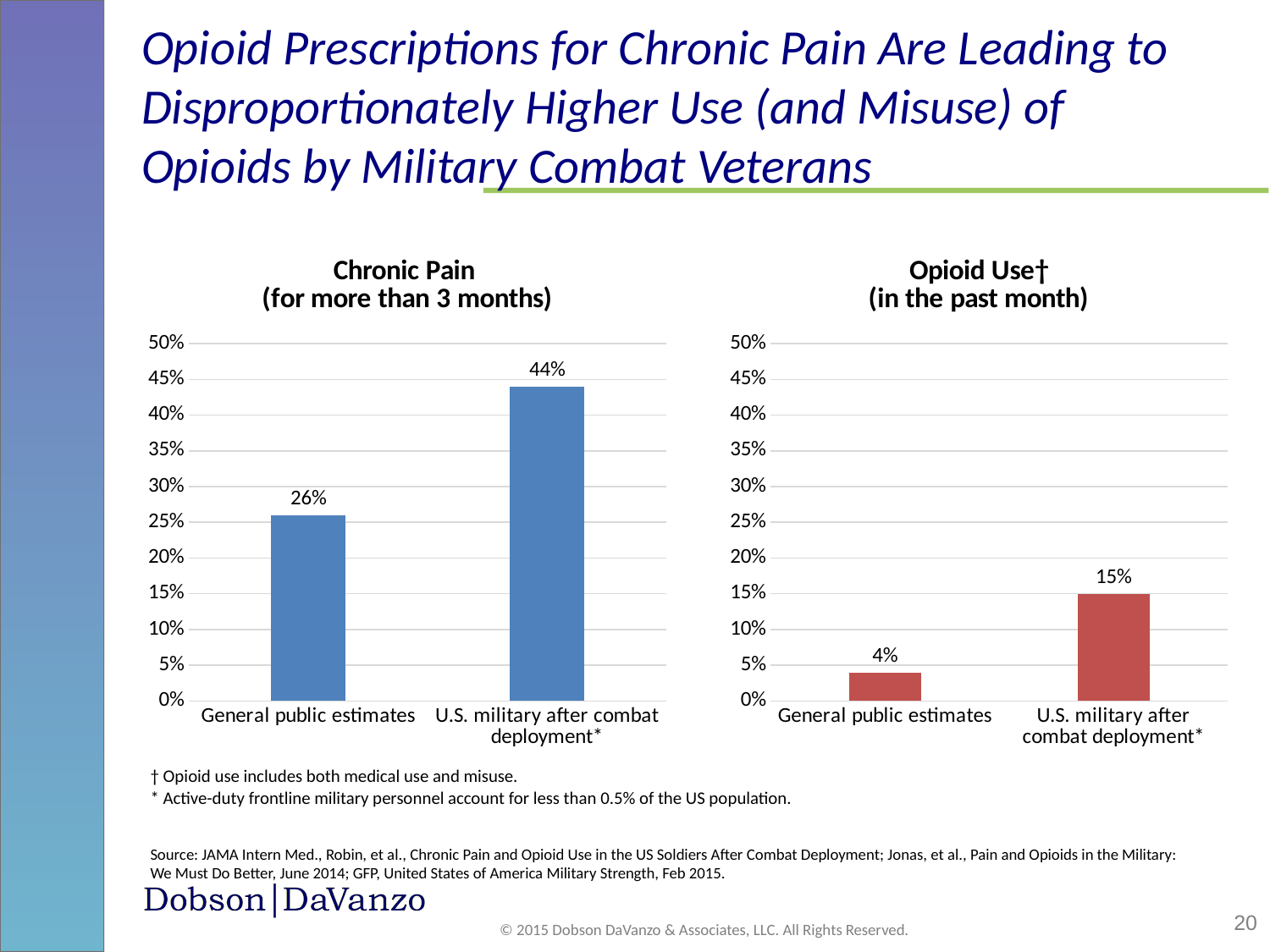
In the Chronic Pain (for more than 3 months) chart, what is the value for U.S. military after combat deployment*? 44% In the Opioid Use† (in the past month) chart, which category has the lowest value? General public estimates In the Opioid Use† (in the past month) chart, what is the value for General public estimates? 4% In the Chronic Pain (for more than 3 months) chart, what is the difference between the U.S. military after combat deployment* value and the General public estimates value? 18% In the Opioid Use† (in the past month) chart, which is larger: General public estimates or U.S. military after combat deployment*? U.S. military after combat deployment* In the Chronic Pain (for more than 3 months) chart, which category has the highest value? U.S. military after combat deployment* What kind of chart is the Opioid Use† (in the past month) chart? Bar chart How many categories are shown in the Chronic Pain (for more than 3 months) chart? 2 In the Opioid Use† (in the past month) chart, what is the value for U.S. military after combat deployment*? 15% What colour are the bars in the Opioid Use† (in the past month) chart? Red In the Opioid Use† (in the past month) chart, what is the difference between the U.S. military after combat deployment* value and the General public estimates value? 11% In the Chronic Pain (for more than 3 months) chart, what is the value for General public estimates? 26%